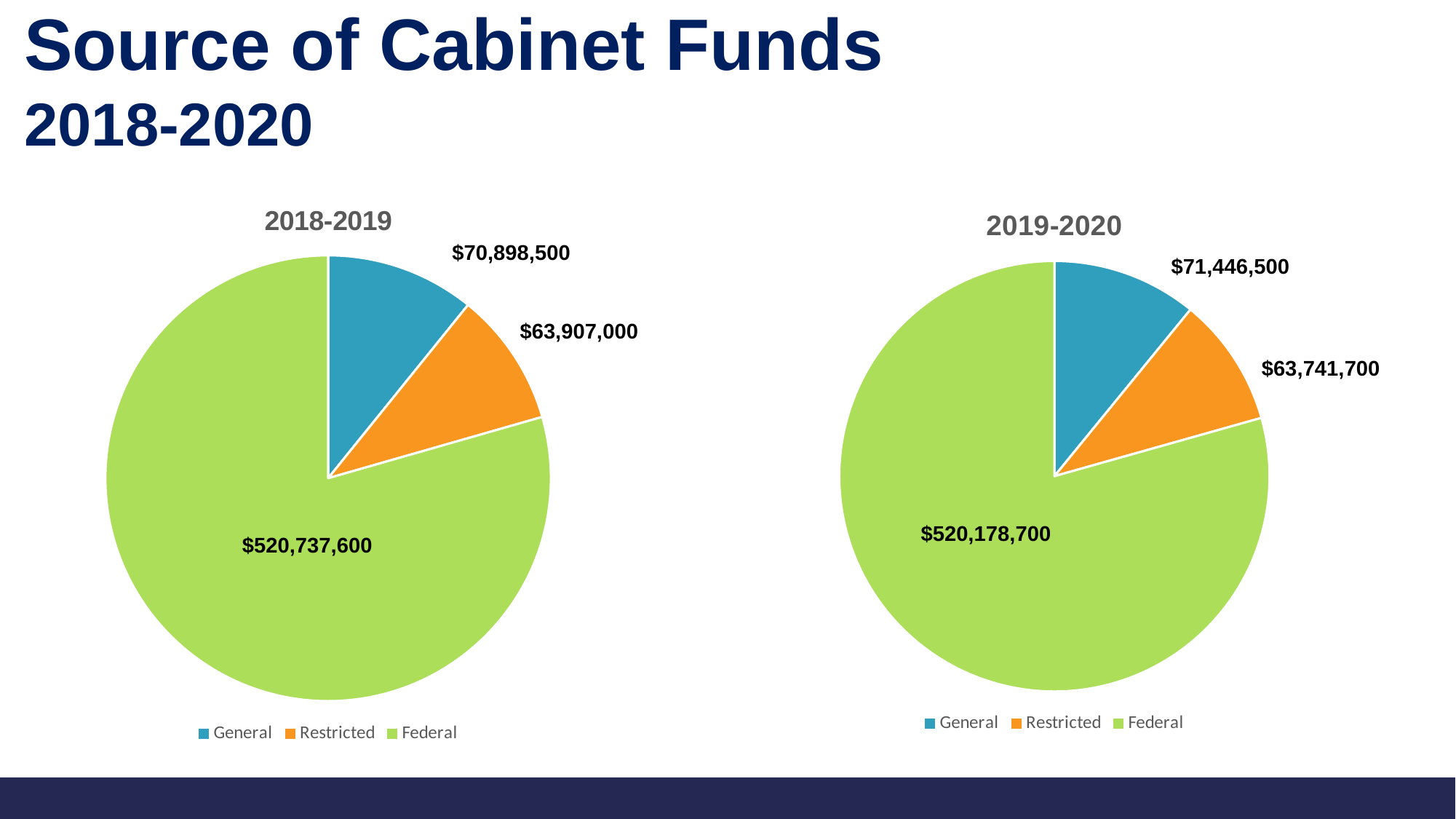
What kind of chart is the 2019-2020 chart? Pie chart In the 2019-2020 chart, what is the value for Restricted? $63,741,700 How many categories does the 2018-2019 chart show? 3 In the 2019-2020 chart, what is the value for Federal? $520,178,700 In the 2018-2019 chart, what colour represents Federal? Green In the 2018-2019 chart, what is the value for Restricted? $63,907,000 Is the General value larger in the 2018-2019 chart or the 2019-2020 chart? 2019-2020 In the 2018-2019 chart, what is the difference between General and Restricted? $6,991,500 In the 2018-2019 chart, which category has the smallest value? Restricted In the 2019-2020 chart, which category has the largest value? Federal What is the total of all three categories in the 2019-2020 chart? $655,366,900 In the 2018-2019 chart, what is the value for General? $70,898,500